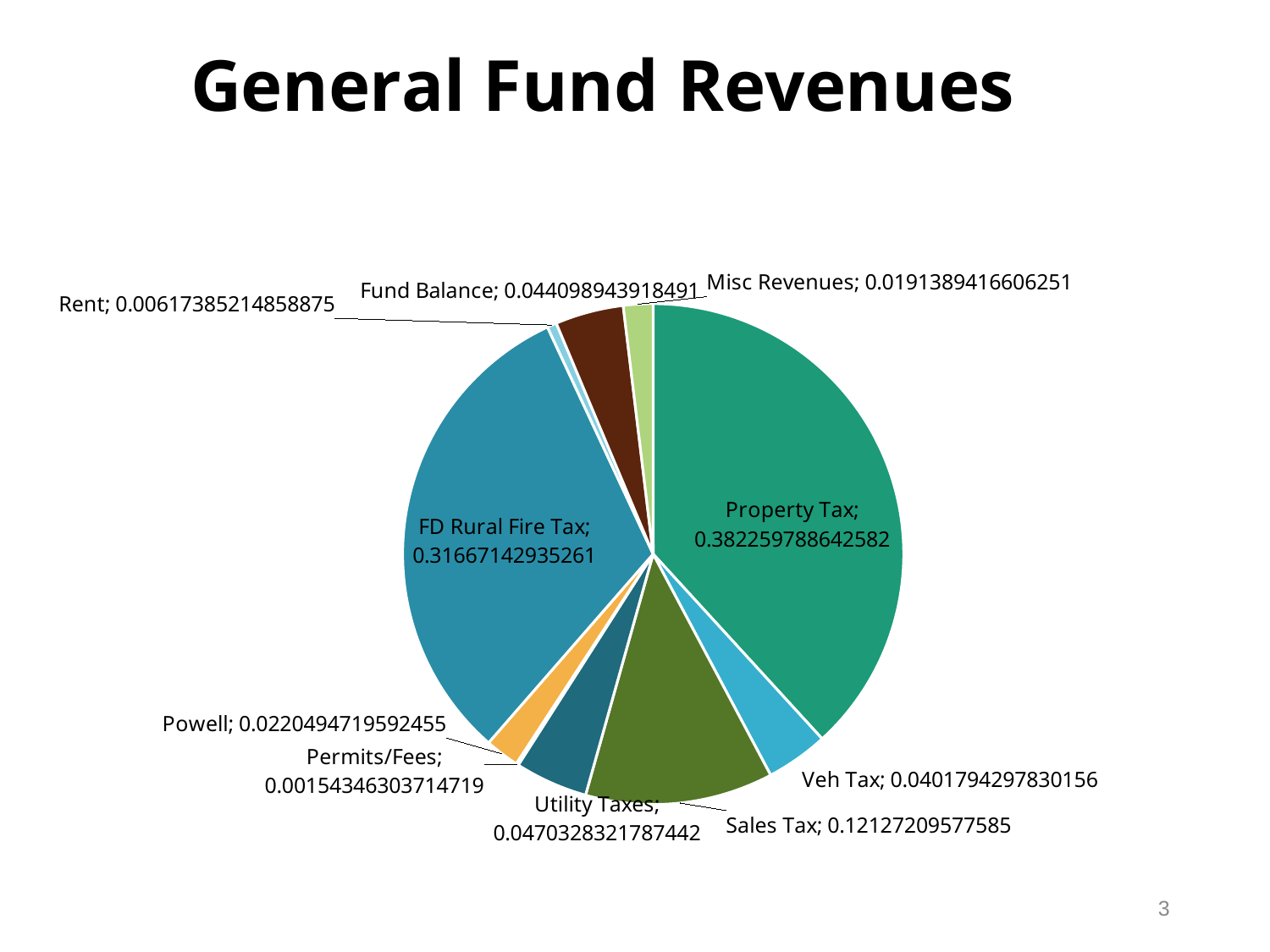
What is the value shown for Veh Tax? 0.0401794297830156 Which category has the smallest slice of the pie? Permits/Fees How many slices does the pie chart have? 10 What is the value shown for Property Tax? 0.382259788642582 What is the value shown for Powell? 0.0220494719592455 What is the title of the chart? General Fund Revenues What is the value shown for FD Rural Fire Tax? 0.31667142935261 What is the value shown for Sales Tax? 0.12127209577585 What type of chart is shown on the slide? pie chart Which category has the largest slice of the pie? Property Tax Which is larger, Sales Tax or Veh Tax? Sales Tax What is the value shown for Rent? 0.00617385214858875